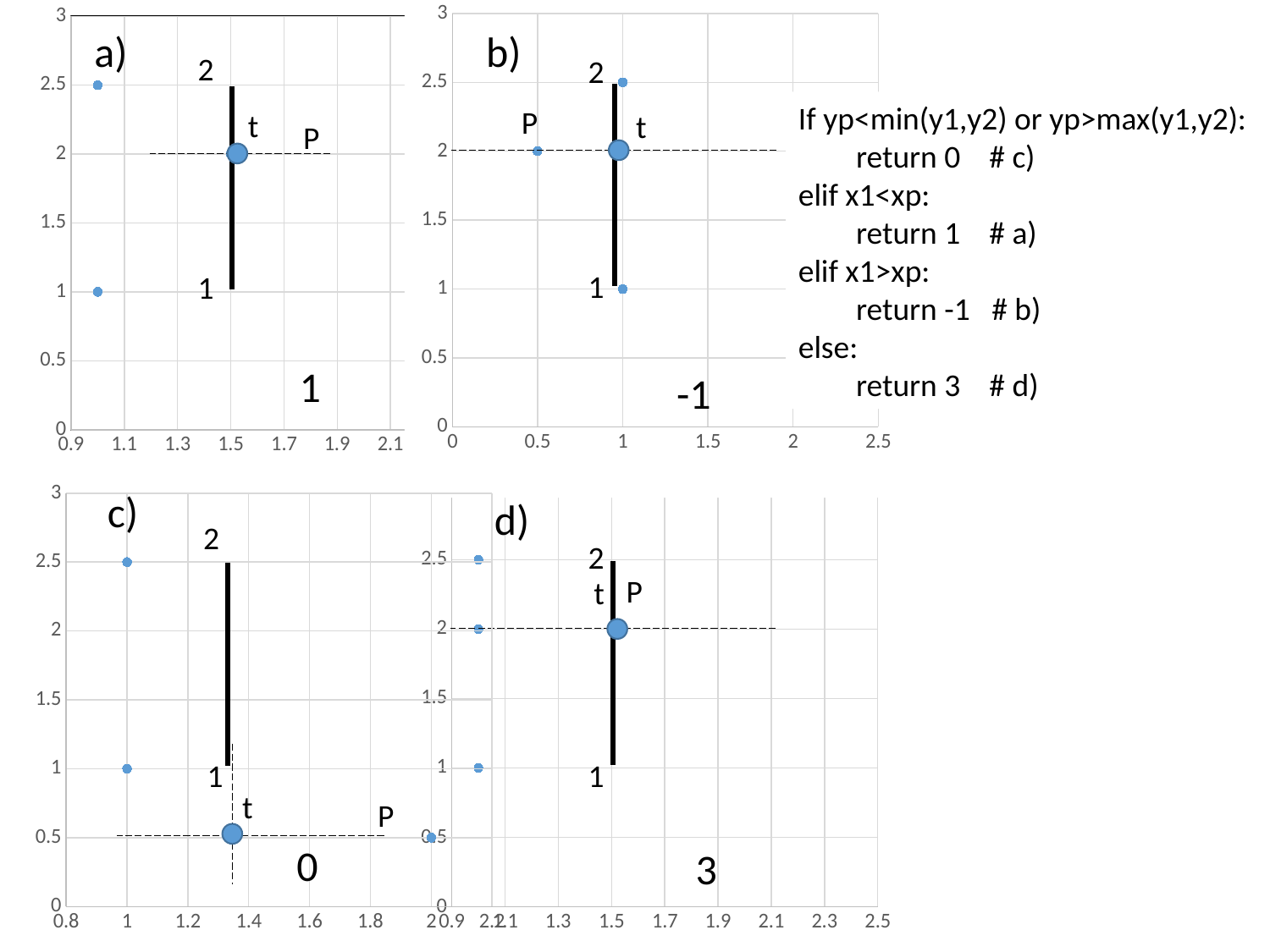
In chart b), which point has the larger x-coordinate, P or t? t What kind of chart is chart a) in the top-left? scatter chart In chart d), what is the x-coordinate of the large point labelled t/P? 1.5 In chart c), what is the y-coordinate of the point labelled t? 0.5 What return value is printed in large type at the bottom of chart d)? 3 In chart b), what is the y-coordinate of the segment endpoint labelled 2? 2.5 In chart b), what is the y-coordinate of the point labelled P? 2 How many charts are shown on the slide? 4 In chart b), what is the x-coordinate of the point labelled P? 0.5 In chart c), is the y-coordinate of the point labelled t greater or less than 1? less In chart d), what is the y-coordinate of the large point labelled t/P? 2 What return value is printed in large type at the bottom of chart b)? -1